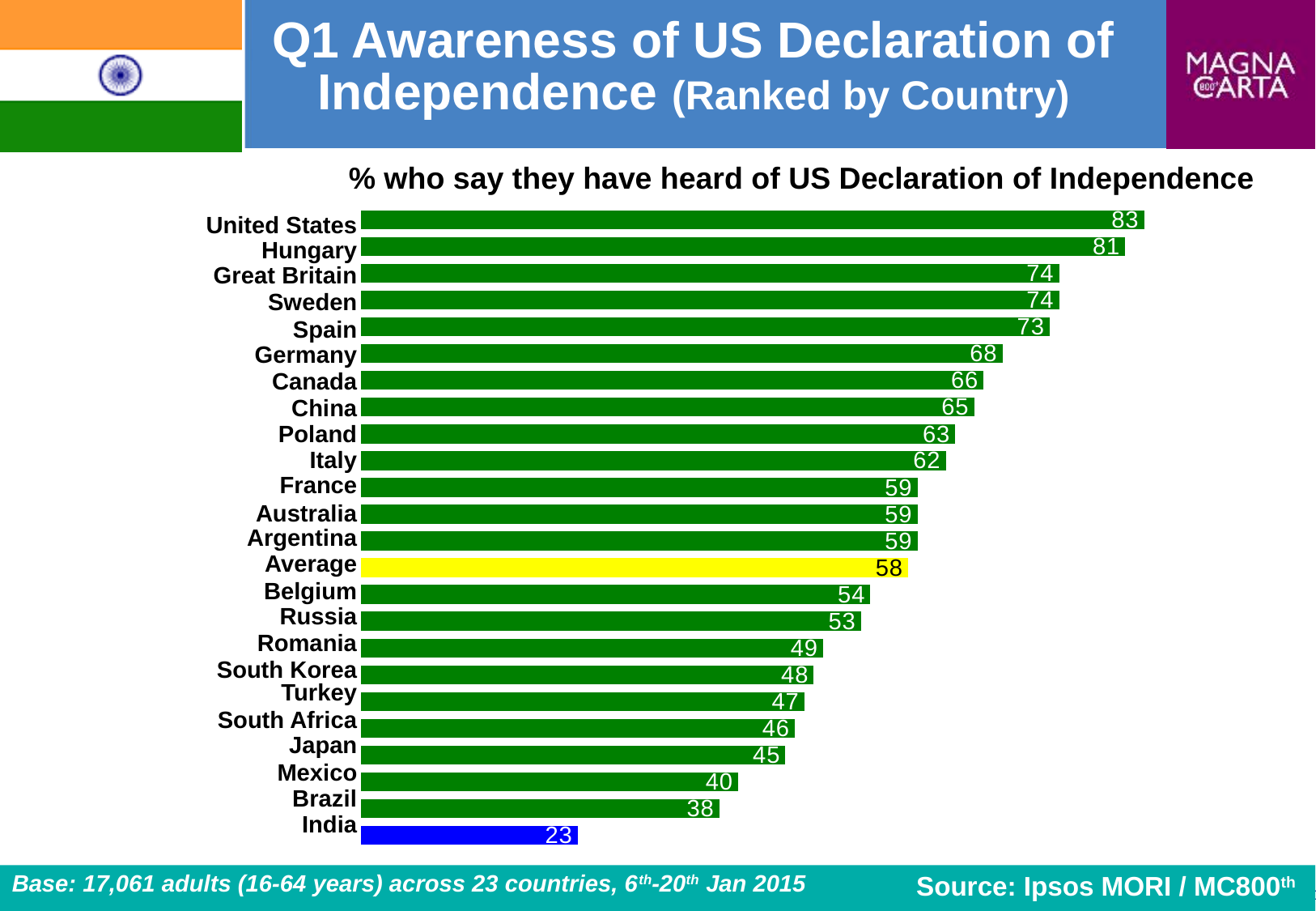
Which has a larger value, Canada or Belgium? Canada What is the difference between the values for Hungary and Spain? 8 Which country has the lowest value? India Which bar is coloured blue rather than green? India How many bars are shown in the chart, including the Average bar? 24 What is the value for Germany? 68 What is the value for India? 23 What is the value for the United States? 83 What is the difference between the values for the United States and India? 60 What is the value for the Average bar? 58 Which country has the highest value? United States What kind of chart is shown on the slide? Bar chart